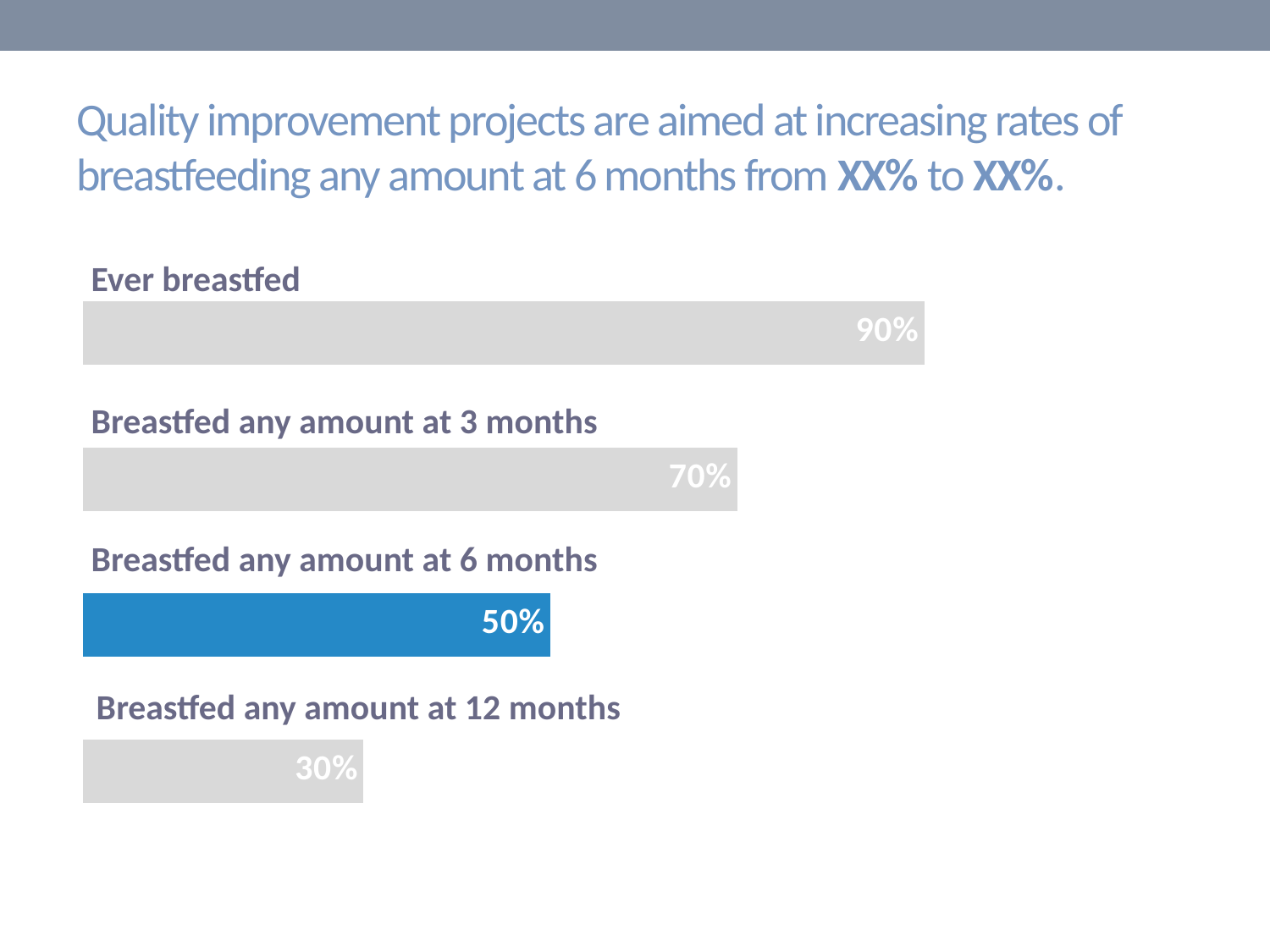
What is the value for Breastfed any amount at 6 months? 50% What is the value for Breastfed any amount at 12 months? 30% What is the difference between the values for Breastfed any amount at 3 months and Breastfed any amount at 6 months? 20% Which category has the highest value? Ever breastfed What is the value for Ever breastfed? 90% How many categories are shown in the chart? 4 Which is larger, the value for Breastfed any amount at 3 months or Breastfed any amount at 12 months? Breastfed any amount at 3 months What is the value for Breastfed any amount at 3 months? 70% What kind of chart is shown on the slide? Bar chart Which bar is highlighted in blue rather than grey? Breastfed any amount at 6 months Which category has the lowest value? Breastfed any amount at 12 months What is the difference between the values for Ever breastfed and Breastfed any amount at 12 months? 60%